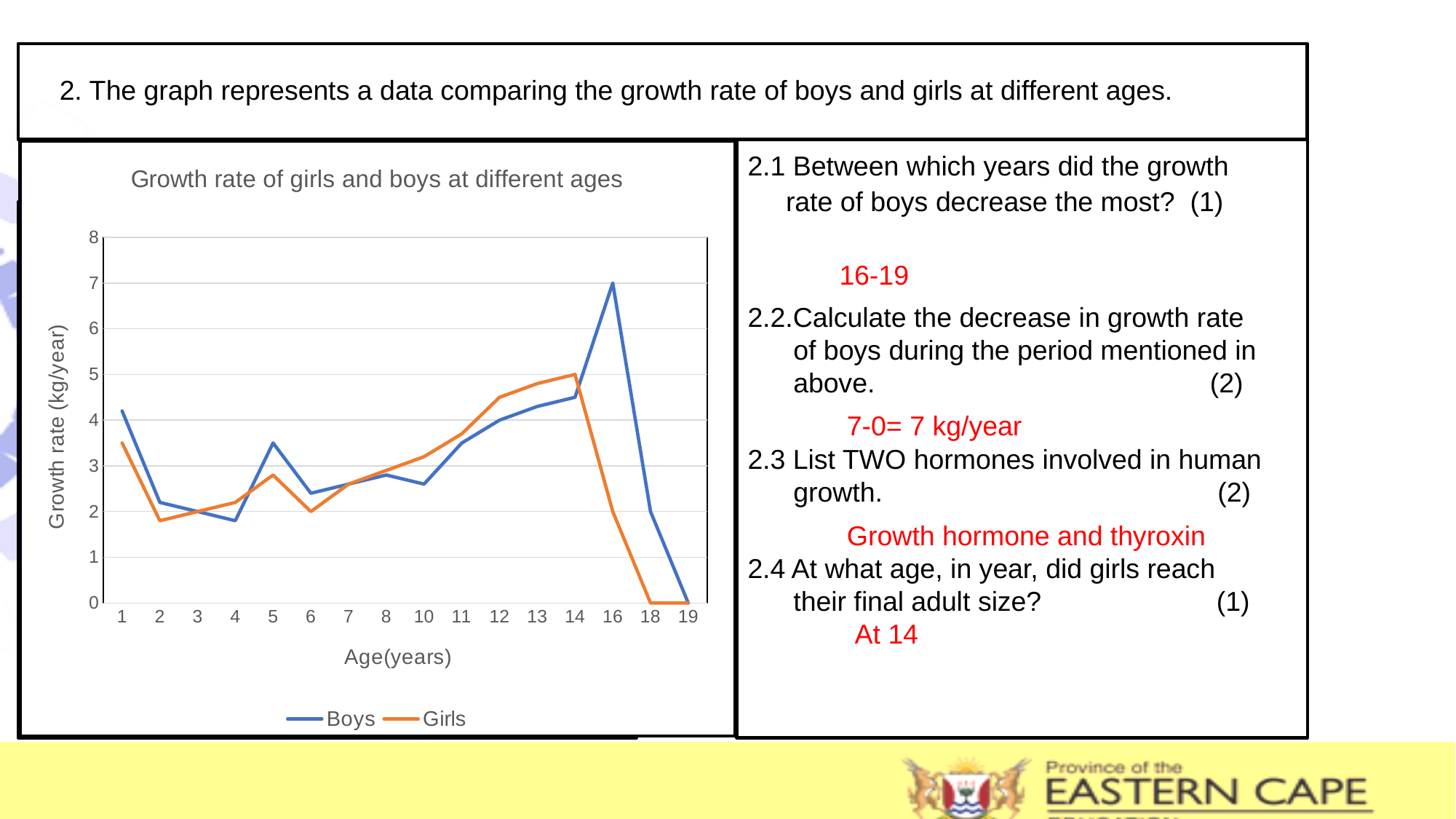
What is the title of the chart? Growth rate of girls and boys at different ages What type of chart is shown on the slide? Line chart Is the growth rate of girls at age 12 greater or less than 4? greater How many series does the chart legend list? 2 At age 5, which series has the higher growth rate, Boys or Girls? Boys What is the growth rate of boys at age 19? 0 At which age is the growth rate of girls highest? 14 At which age is the growth rate of boys highest? 16 What is the growth rate of girls at age 14? 5 How many age points are plotted along the x axis of the chart? 16 What is the growth rate of boys at age 16? 7 What is the difference between the growth rate of boys at age 16 and at age 19? 7